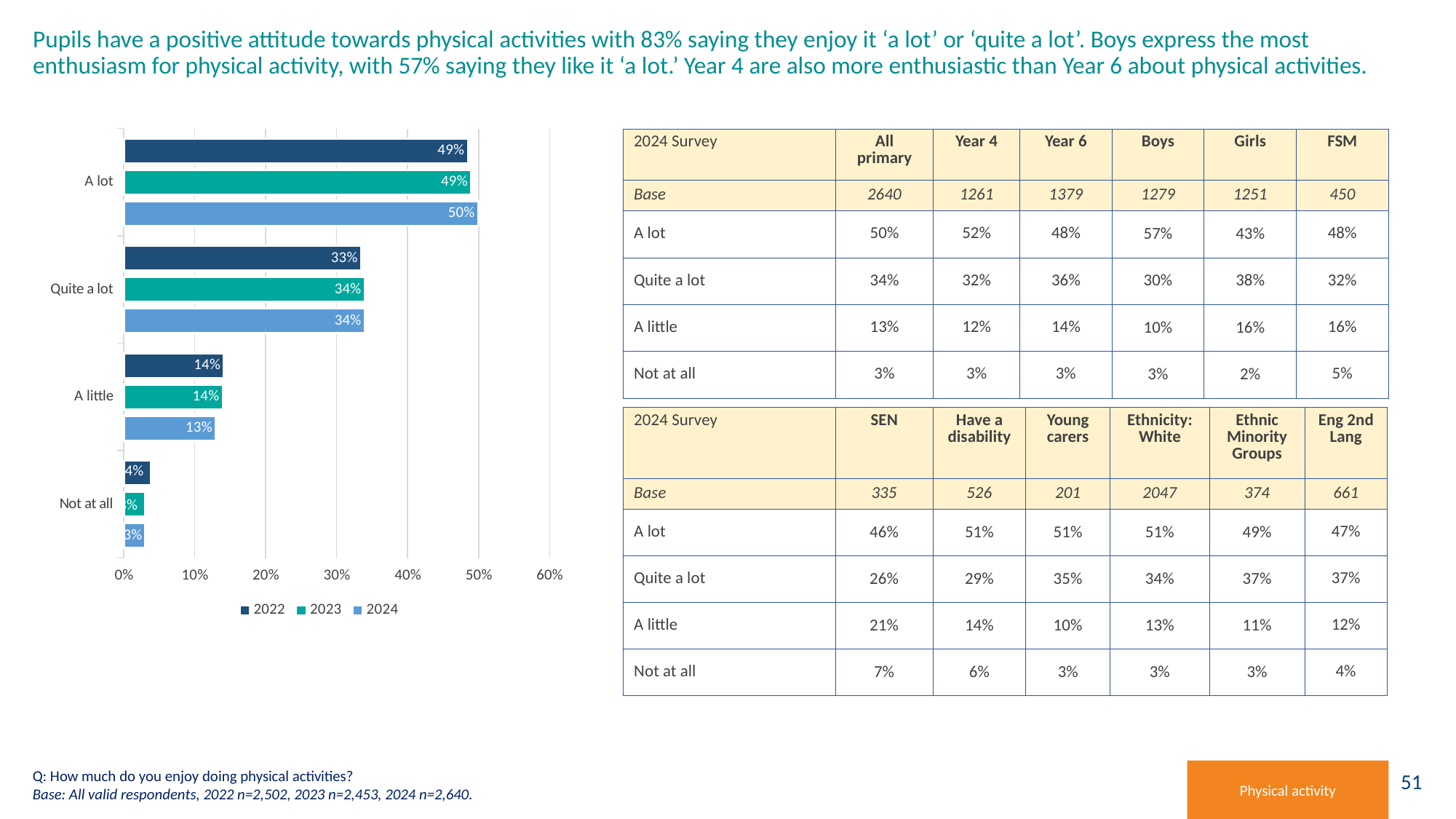
How many series does the chart legend list? 3 How many response categories are shown on the chart? 4 Which response category has the lowest value for 2022 in the chart? Not at all Which response category has the highest value for 2024 in the chart? A lot What is the 2022 value for 'Quite a lot' in the chart? 33% What is the 2022 value for 'Not at all' in the chart? 4% What is the 2024 value for 'A lot' in the chart? 50% What is the 2023 value for 'A little' in the chart? 14% Which series in the chart legend is shown in the darkest blue colour? 2022 Is the 2024 value for 'A little' larger or smaller than the 2024 value for 'Quite a lot'? smaller What kind of chart is shown on the slide? bar chart What is the difference between the 2024 values for 'A lot' and 'Quite a lot' in the chart? 16%